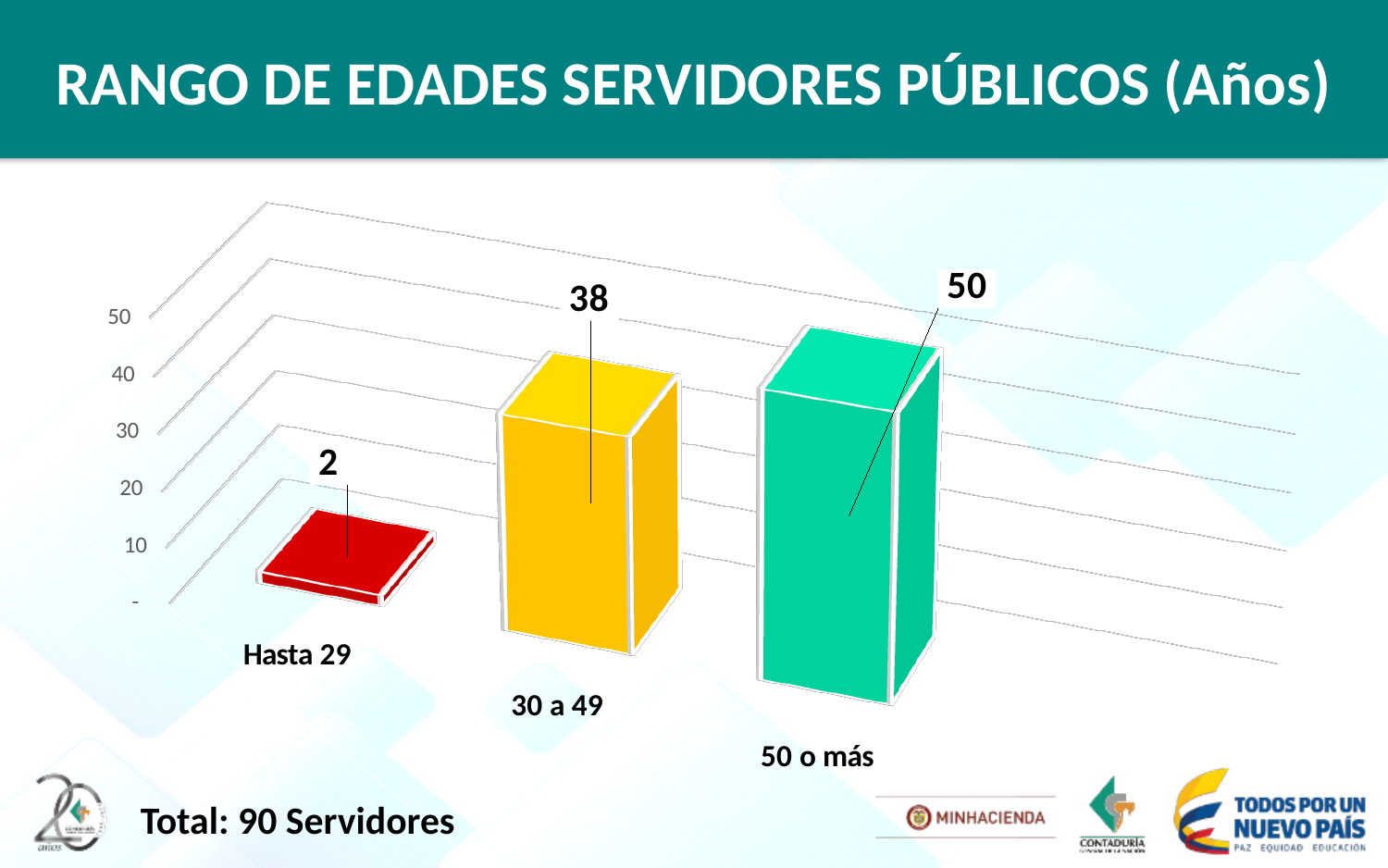
Which age range has the highest value? 50 o más What is the value for the '50 o más' age range? 50 What kind of chart is shown on the slide? bar chart Which is larger, the value for '30 a 49' or the value for 'Hasta 29'? 30 a 49 What is the difference between the values for '50 o más' and '30 a 49'? 12 How many age ranges are shown in the chart? 3 Is the value for '30 a 49' greater or less than 30? greater Do the values rise or fall from left to right across the age ranges? rise What is the value for the '30 a 49' age range? 38 What is the value for the 'Hasta 29' age range? 2 What is the difference between the values for '30 a 49' and 'Hasta 29'? 36 Which age range has the lowest value? Hasta 29